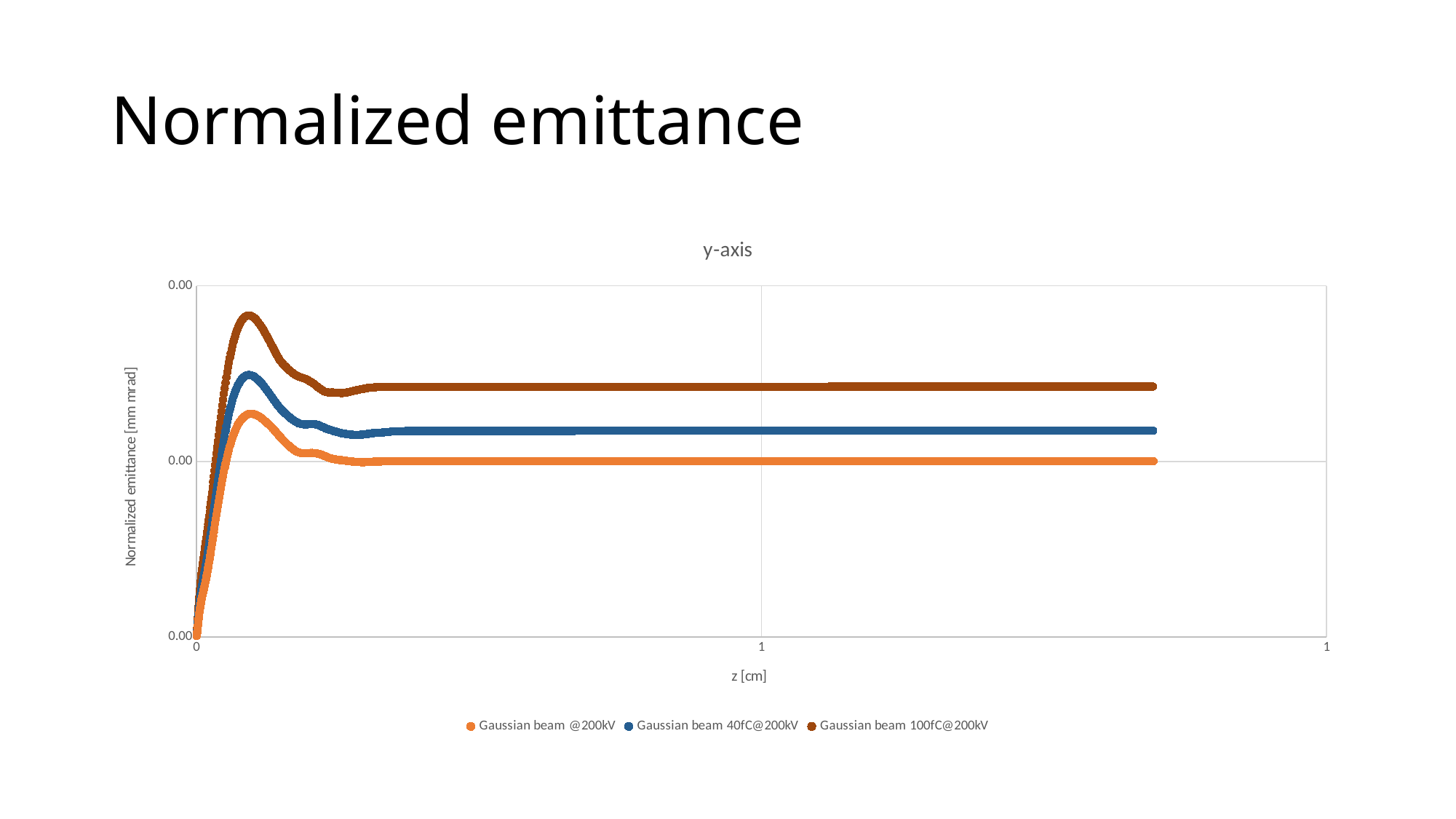
What kind of chart is shown on the slide? Scatter (line) chart How does the normalized emittance of each series behave along the z axis? Rises sharply to a peak, dips, then stays flat Which series reaches the highest peak near the start of the z axis? Gaussian beam 100fC@200kV What is the label of the horizontal axis? z [cm] Which series is plotted in blue? Gaussian beam 40fC@200kV How many series does the legend list? 3 Which series has the lowest normalized emittance across the plotted range? Gaussian beam @200kV Which series has a larger normalized emittance at the right end of the plot, Gaussian beam @200kV or Gaussian beam 40fC@200kV? Gaussian beam 40fC@200kV Which series has a larger normalized emittance at the right end of the plot, Gaussian beam 40fC@200kV or Gaussian beam 100fC@200kV? Gaussian beam 100fC@200kV Which series has the highest normalized emittance across the plotted range? Gaussian beam 100fC@200kV What is the title of the chart? y-axis